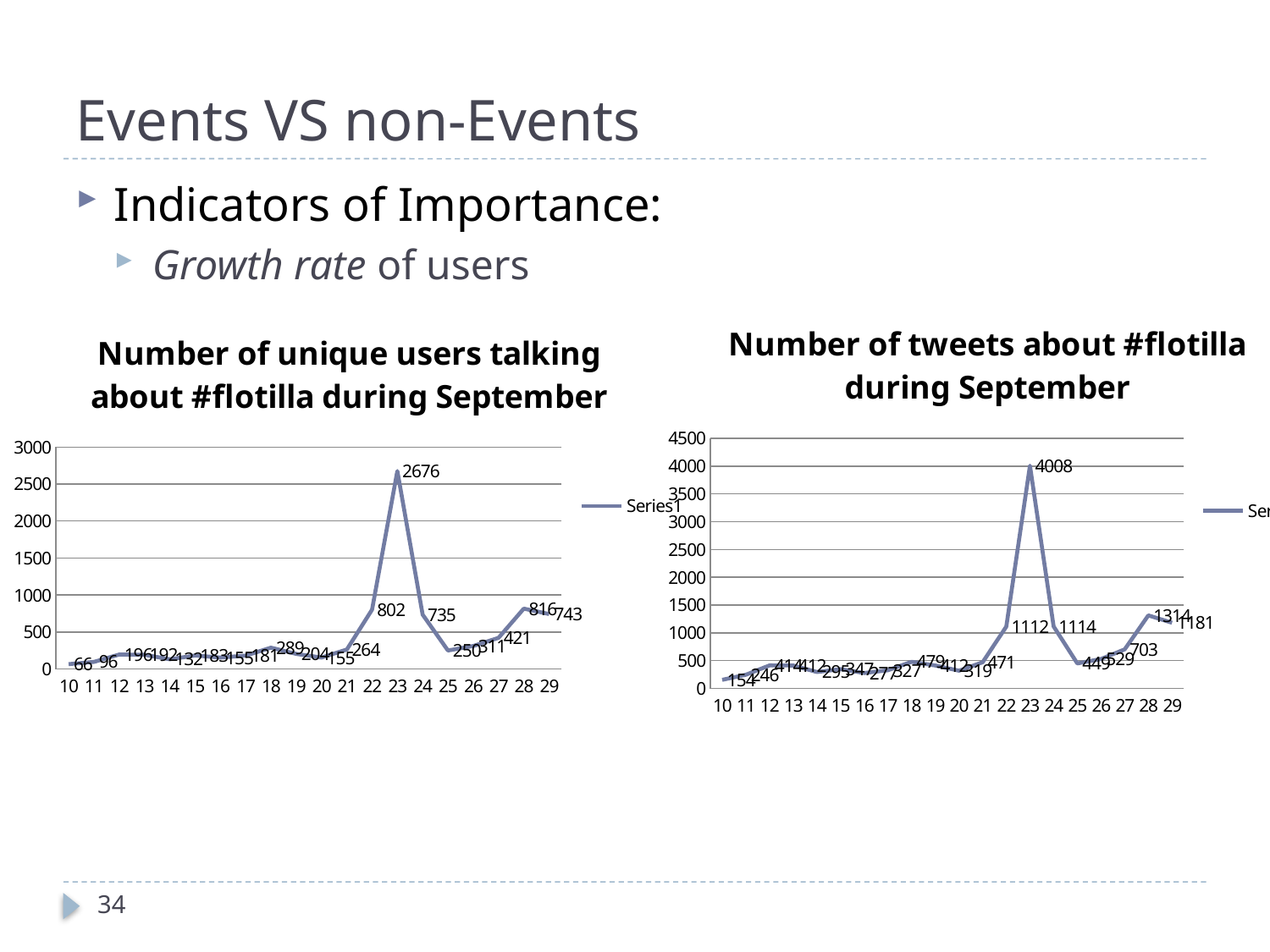
How many days are plotted on the x axis of the chart 'Number of unique users talking about #flotilla during September'? 20 In the chart 'Number of unique users talking about #flotilla during September', what is the value on day 23? 2676 In the chart 'Number of unique users talking about #flotilla during September', is the value on day 22 greater or less than 500? greater In the chart 'Number of unique users talking about #flotilla during September', what is the value on day 10? 66 In the chart 'Number of tweets about #flotilla during September', what is the value on day 28? 1314 In the chart 'Number of unique users talking about #flotilla during September', which day has the highest value? 23 What type of chart is 'Number of tweets about #flotilla during September'? line chart In the chart 'Number of tweets about #flotilla during September', what is the difference between the values on day 23 and day 24? 2894 In the chart 'Number of tweets about #flotilla during September', which is larger, the value on day 22 or the value on day 27? day 22 In the chart 'Number of unique users talking about #flotilla during September', what is the difference between the values on day 28 and day 29? 73 In the chart 'Number of tweets about #flotilla during September', what is the value on day 23? 4008 In the chart 'Number of tweets about #flotilla during September', which day has the lowest value? 10